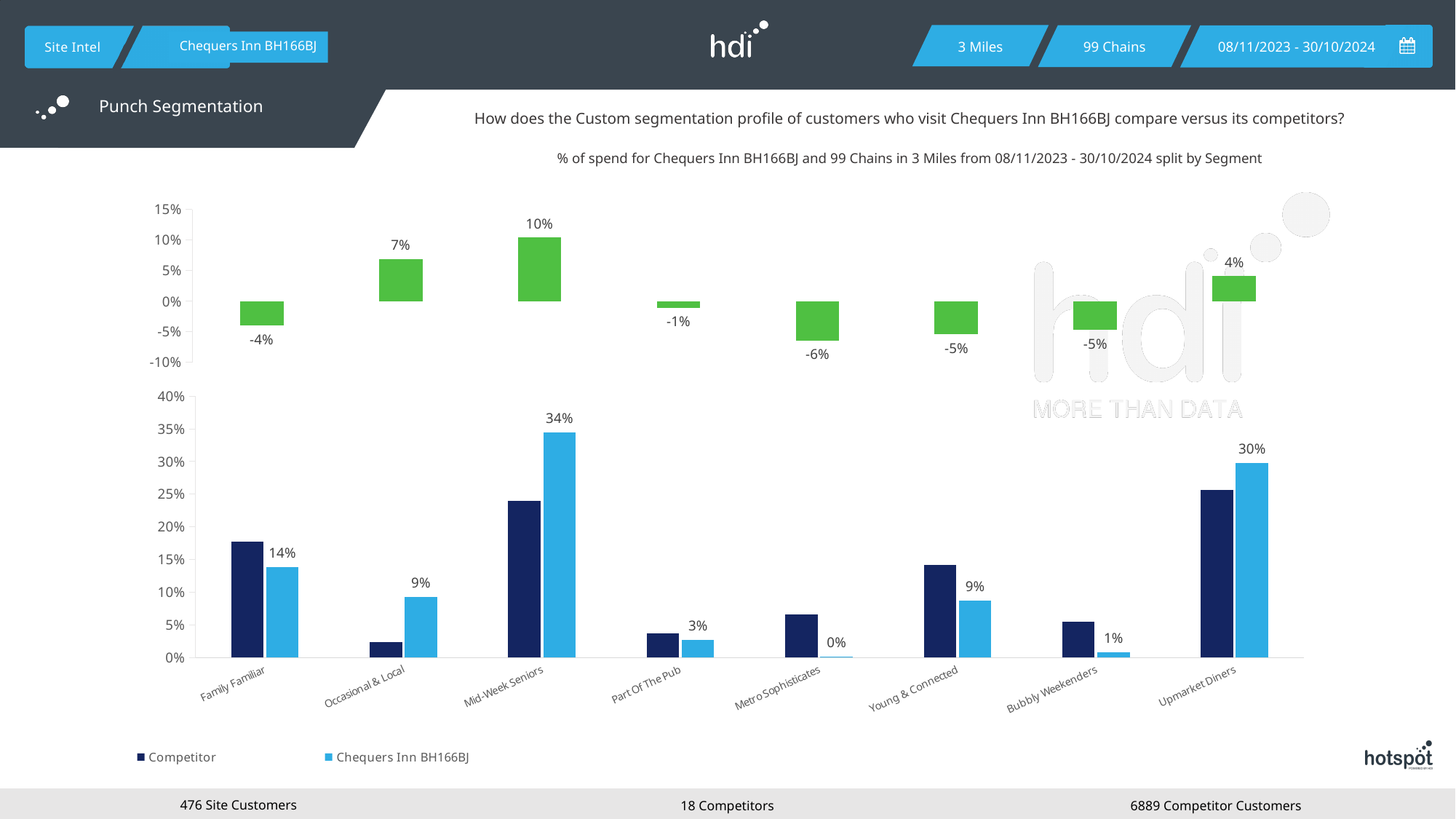
In the bottom chart, what is the value for Chequers Inn BH166BJ for Upmarket Diners? 30% In the top chart, which segment has the lowest value? Metro Sophisticates How many series does the legend of the bottom chart list? 2 In the top chart, what is the difference between the values for Mid-Week Seniors and Occasional & Local? 3% In the top chart, what is the value shown for Metro Sophisticates? -6% What type of chart is the bottom chart? Bar chart How many segments are shown on the x axis of the bottom chart? 8 In the bottom chart, is the Competitor value for Mid-Week Seniors greater or less than 20%? greater In the bottom chart, which is larger for Family Familiar: the Competitor bar or the Chequers Inn BH166BJ bar? Competitor In the top chart, which segment has the highest value? Mid-Week Seniors In the bottom chart, what is the value for Chequers Inn BH166BJ for Mid-Week Seniors? 34% In the bottom chart, which segment has the lowest Chequers Inn BH166BJ value? Metro Sophisticates